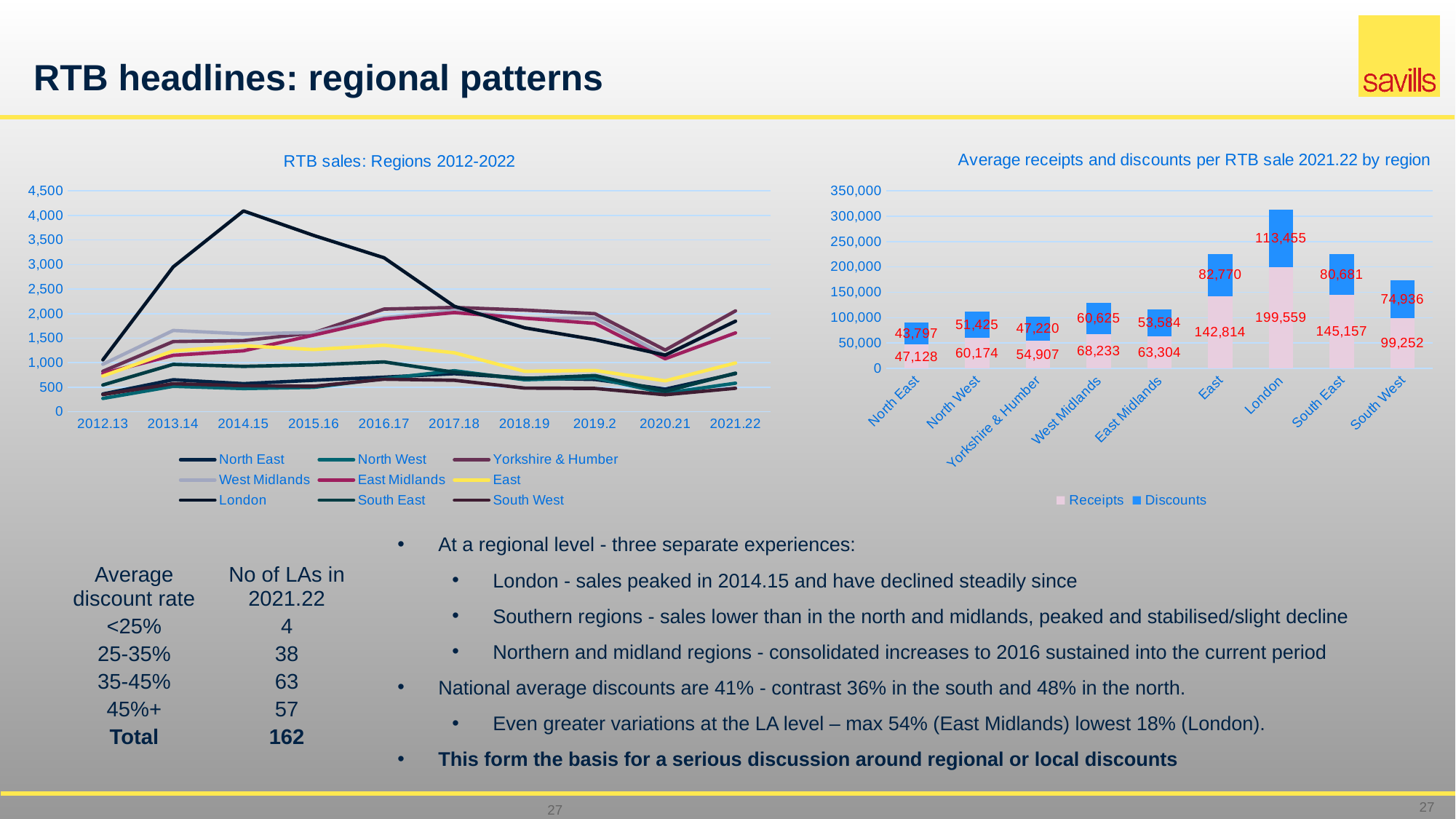
In the 'Average receipts and discounts per RTB sale 2021.22 by region' chart, which region has the highest Receipts value? London In the 'Average receipts and discounts per RTB sale 2021.22 by region' chart, what is the Receipts value for London? 199,559 In the 'Average receipts and discounts per RTB sale 2021.22 by region' chart, which region has the lowest Discounts value? North East How many series does the legend of the 'RTB sales: Regions 2012-2022' chart list? 9 In the 'RTB sales: Regions 2012-2022' chart, does the London line rise or fall between 2014.15 and 2020.21? Fall In the 'Average receipts and discounts per RTB sale 2021.22 by region' chart, is the Discounts value larger for North West or Yorkshire & Humber? North West In the 'Average receipts and discounts per RTB sale 2021.22 by region' chart, what is the total of Receipts and Discounts for South West? 174,188 How many regions are shown on the x axis of the 'Average receipts and discounts per RTB sale 2021.22 by region' chart? 9 In the 'RTB sales: Regions 2012-2022' chart, is the value for London in 2014.15 greater or less than 3,500? greater What kind of chart is 'RTB sales: Regions 2012-2022'? Line chart In the 'Average receipts and discounts per RTB sale 2021.22 by region' chart, what is the Discounts value for West Midlands? 60,625 In the 'Average receipts and discounts per RTB sale 2021.22 by region' chart, what is the difference between the Receipts values for South East and East? 2,343